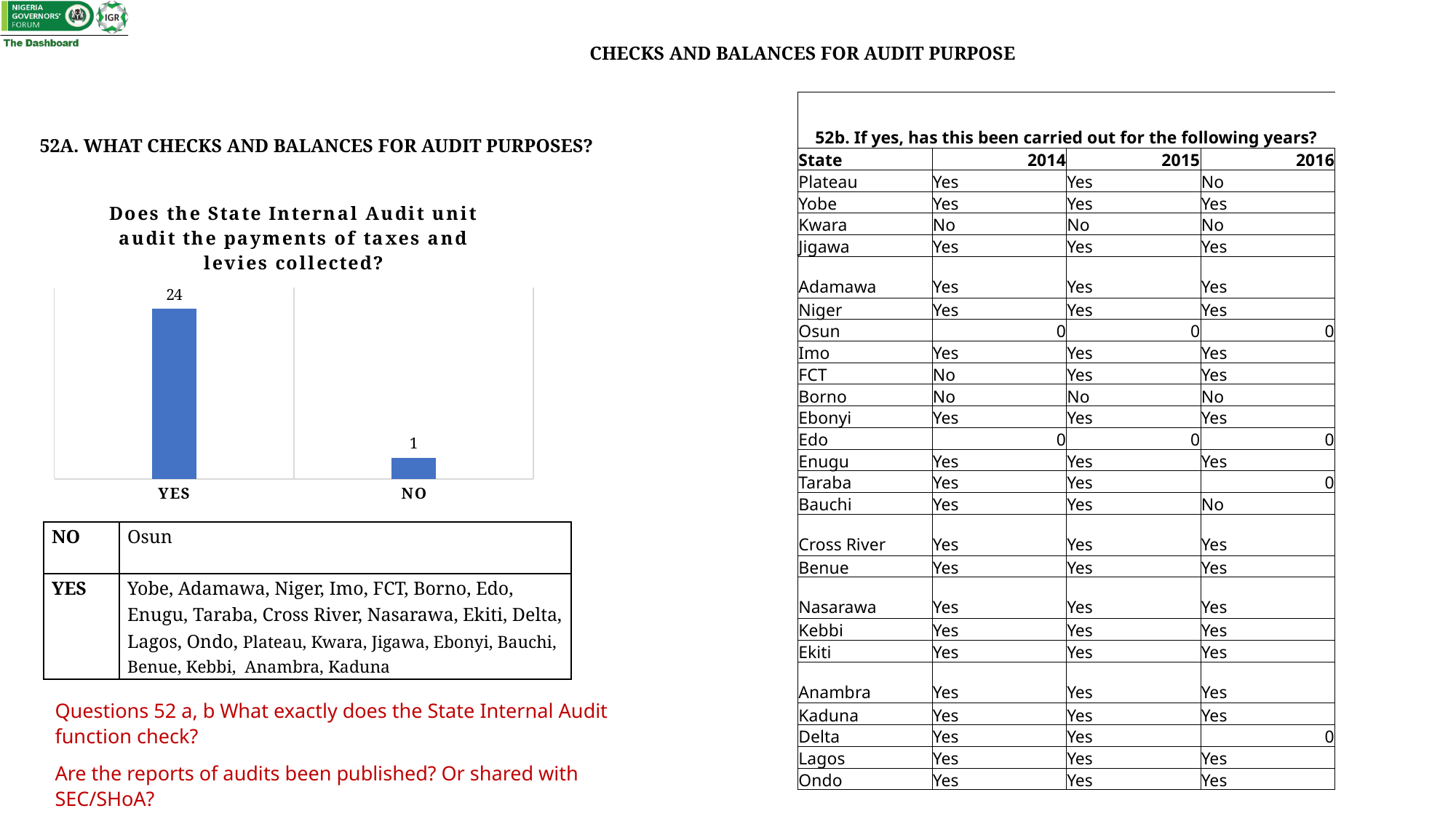
What is the value for YES in the chart 'Does the State Internal Audit unit audit the payments of taxes and levies collected?' 24 Which category has the lowest value in the chart? NO What is the title of the chart on the slide? Does the State Internal Audit unit audit the payments of taxes and levies collected? What colour are the bars in the chart? Blue Which is larger in the chart, the value for YES or the value for NO? YES How many categories are shown in the chart? 2 What is the total of the YES and NO values in the chart? 25 What kind of chart is shown on the slide? Bar chart What is the difference between the YES and NO values in the chart? 23 What is the value for NO in the chart 'Does the State Internal Audit unit audit the payments of taxes and levies collected?' 1 Which category has the highest value in the chart? YES